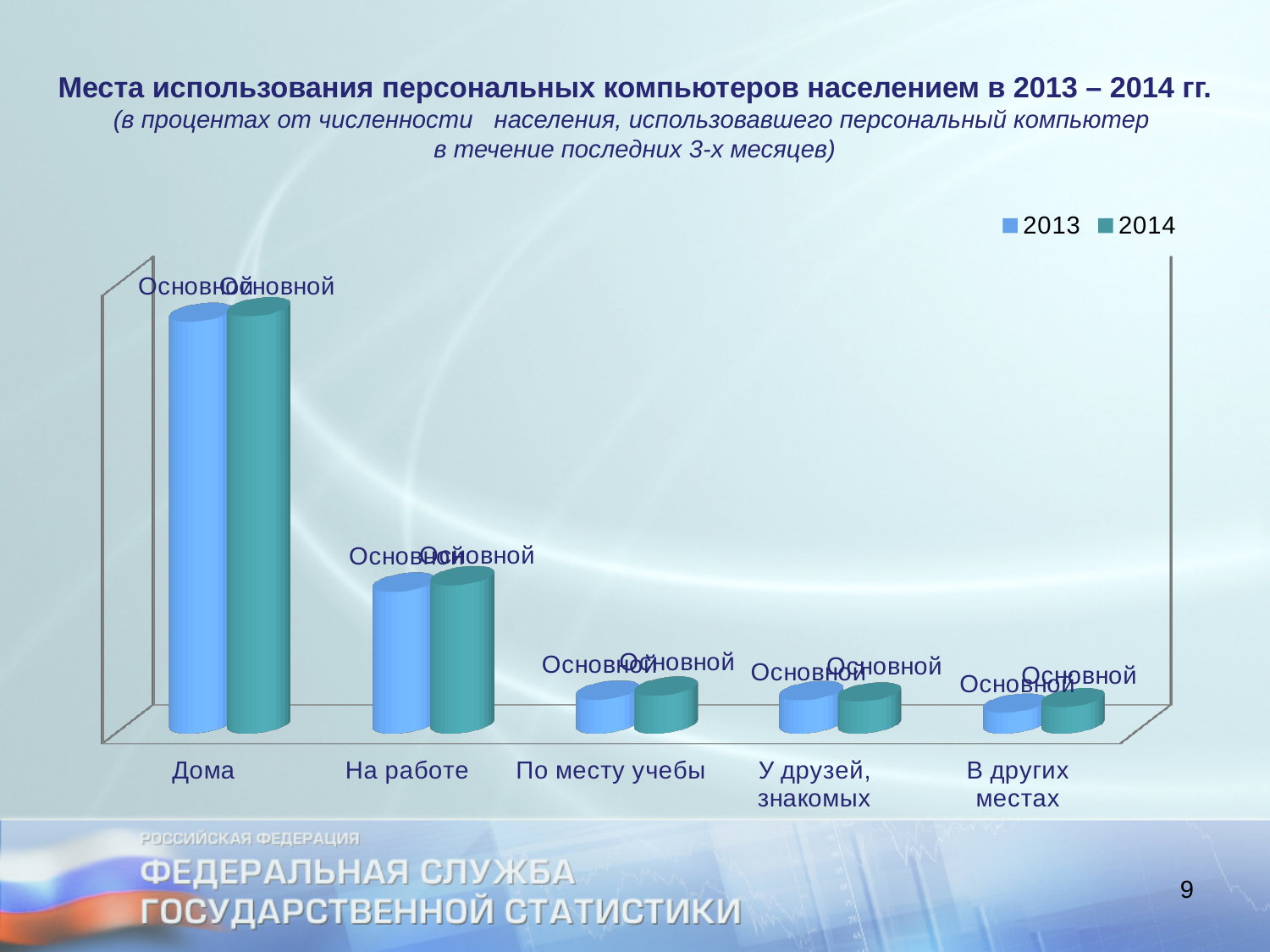
Which category is second highest for 2013? На работе Which category has the highest values for both years? Дома Which category has the lowest value for 2013? В других местах Which years are listed in the legend? 2013 and 2014 Which is larger for 2014: the value for У друзей, знакомых or the value for Дома? Дома How many categories (places of computer use) are shown on the x axis? 5 Which colour represents the 2014 series in the chart? teal (green-blue) Which is larger for 2013: the value for На работе or the value for По месту учебы? На работе What kind of chart is shown on the slide? bar chart Which is larger for 2014: the value for Дома or the value for На работе? Дома How many series does the legend list? 2